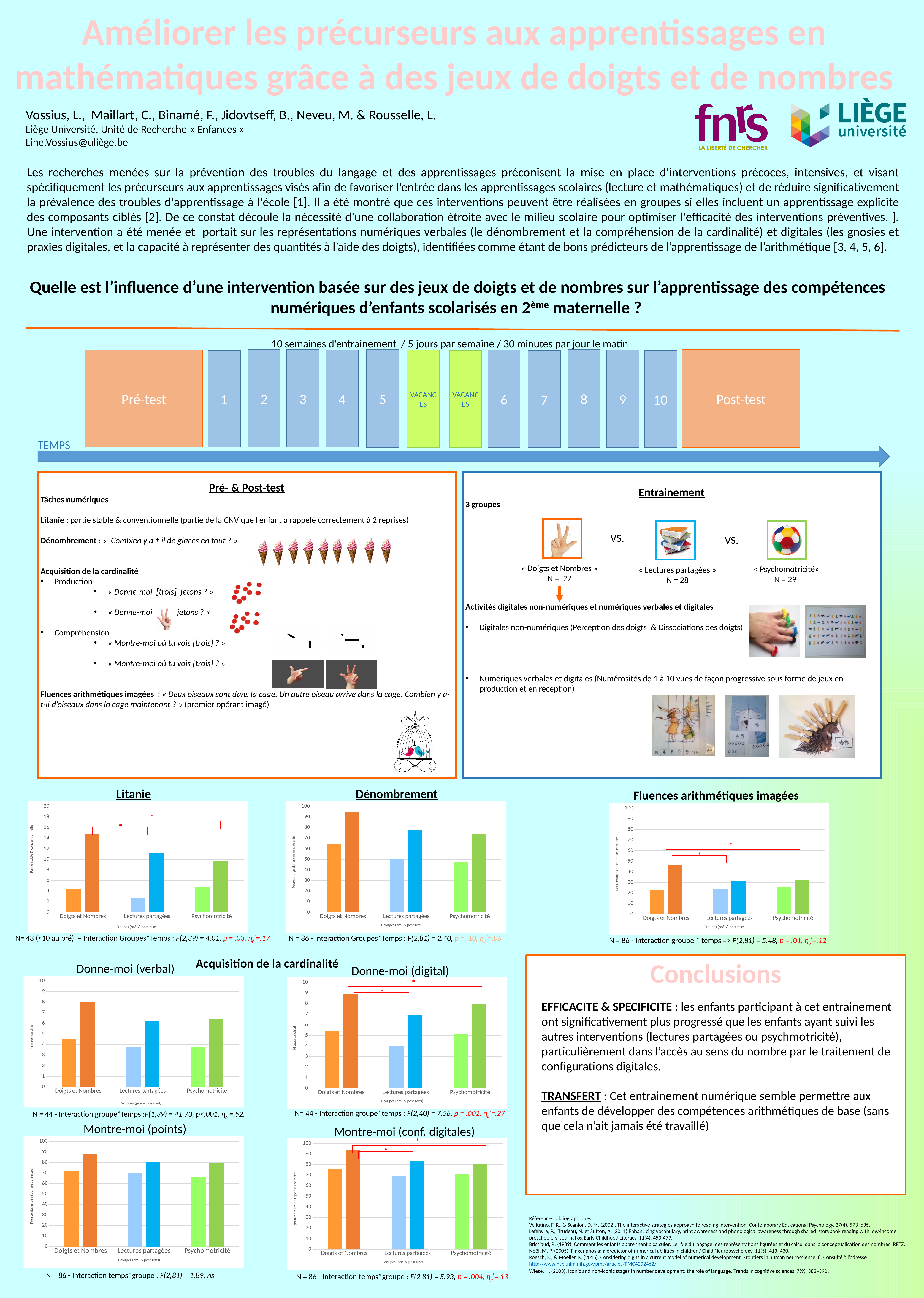
On the 'Litanie' chart, what kind of chart is it? bar chart On the 'Litanie' chart, how many groups are shown on the x axis? 3 On the 'Litanie' chart, which group has the tallest bar? Doigts et Nombres On the 'Donne-moi (digital)' chart, which group has the taller tallest bar, Doigts et Nombres or Lectures partagées? Doigts et Nombres On the 'Montre-moi (conf. digitales)' chart, is the tallest bar for Doigts et Nombres greater or less than 85? greater On the 'Donne-moi (verbal)' chart, is the tallest bar for Doigts et Nombres greater or less than 7? greater On the 'Fluences arithmétiques imagées' chart, which group has the tallest bar? Doigts et Nombres On the 'Litanie' chart, is the tallest bar for Doigts et Nombres greater or less than 12? greater On the 'Dénombrement' chart, which group has the tallest bar? Doigts et Nombres On the 'Montre-moi (points)' chart, how many groups are shown on the x axis? 3